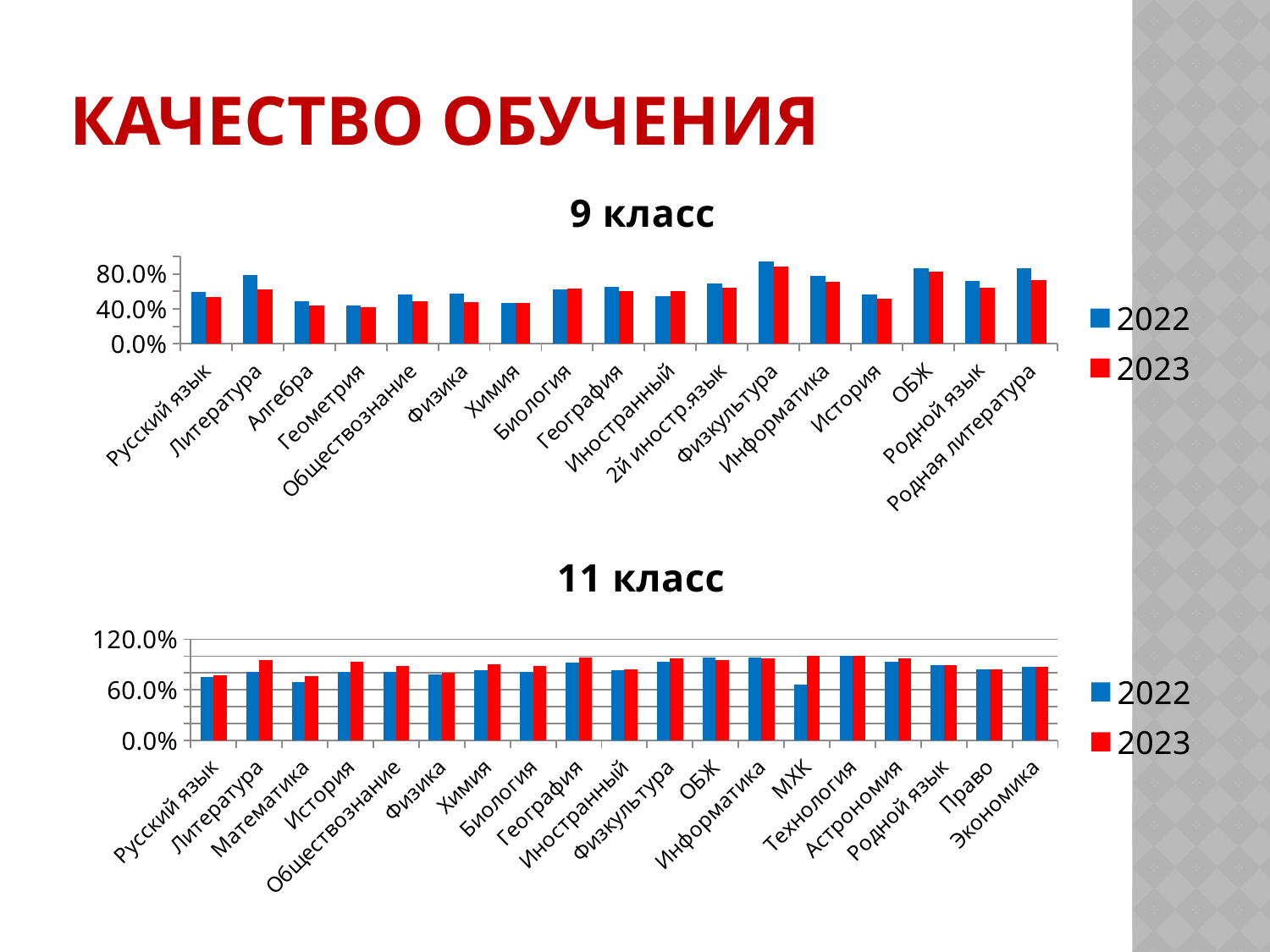
In the "11 класс" chart, which is larger for МХК: the 2022 value or the 2023 value? 2023 In the "9 класс" chart, is the 2022 value for Физкультура greater or less than 80.0%? greater How many subject categories are shown on the "9 класс" chart? 17 In the "9 класс" chart, which is larger for Литература: the 2022 value or the 2023 value? 2022 In the "11 класс" chart, is the 2023 value for Литература greater or less than 60.0%? greater In the "9 класс" chart, is the 2023 value for Геометрия greater or less than 80.0%? less In the "9 класс" chart, which subject has the highest value for 2022? Физкультура In the "11 класс" chart, which colour represents the 2023 series? red In the "11 класс" chart, which subject has the lowest value for 2022? МХК How many series does the legend of the "11 класс" chart list? 2 How many subject categories are shown on the "11 класс" chart? 19 What kind of chart is the "9 класс" chart? bar chart